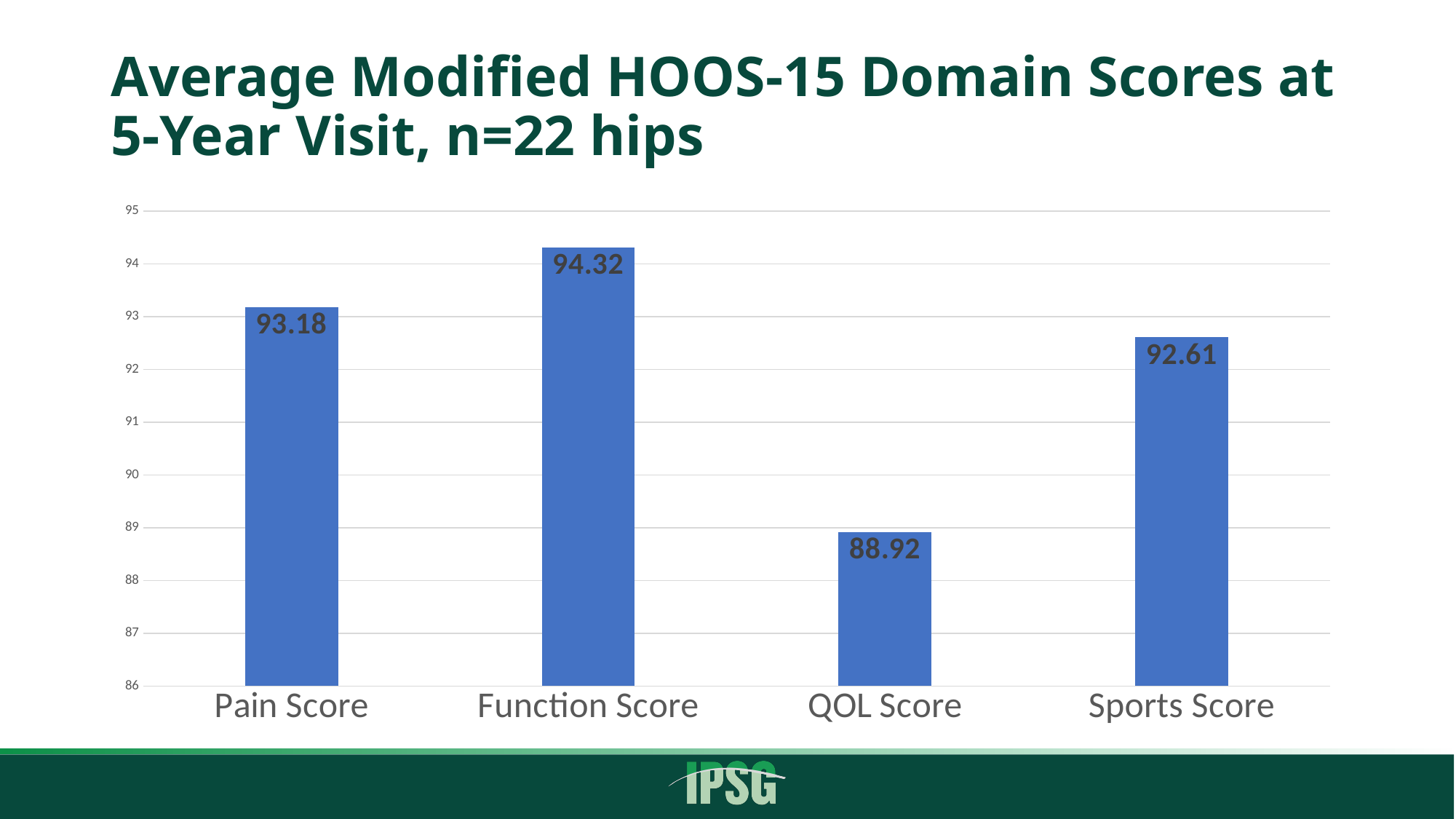
How many categories are shown on the chart? 4 Is the value for QOL Score greater or less than 90? less What kind of chart is shown on the slide? bar chart What is the difference between the Function Score and the QOL Score? 5.40 What is the value for Pain Score? 93.18 Which category has the highest value? Function Score Which is larger, the Pain Score or the Sports Score? Pain Score What is the value for QOL Score? 88.92 What is the difference between the Pain Score and the Sports Score? 0.57 What is the value for Sports Score? 92.61 What is the value for Function Score? 94.32 Which category has the lowest value? QOL Score